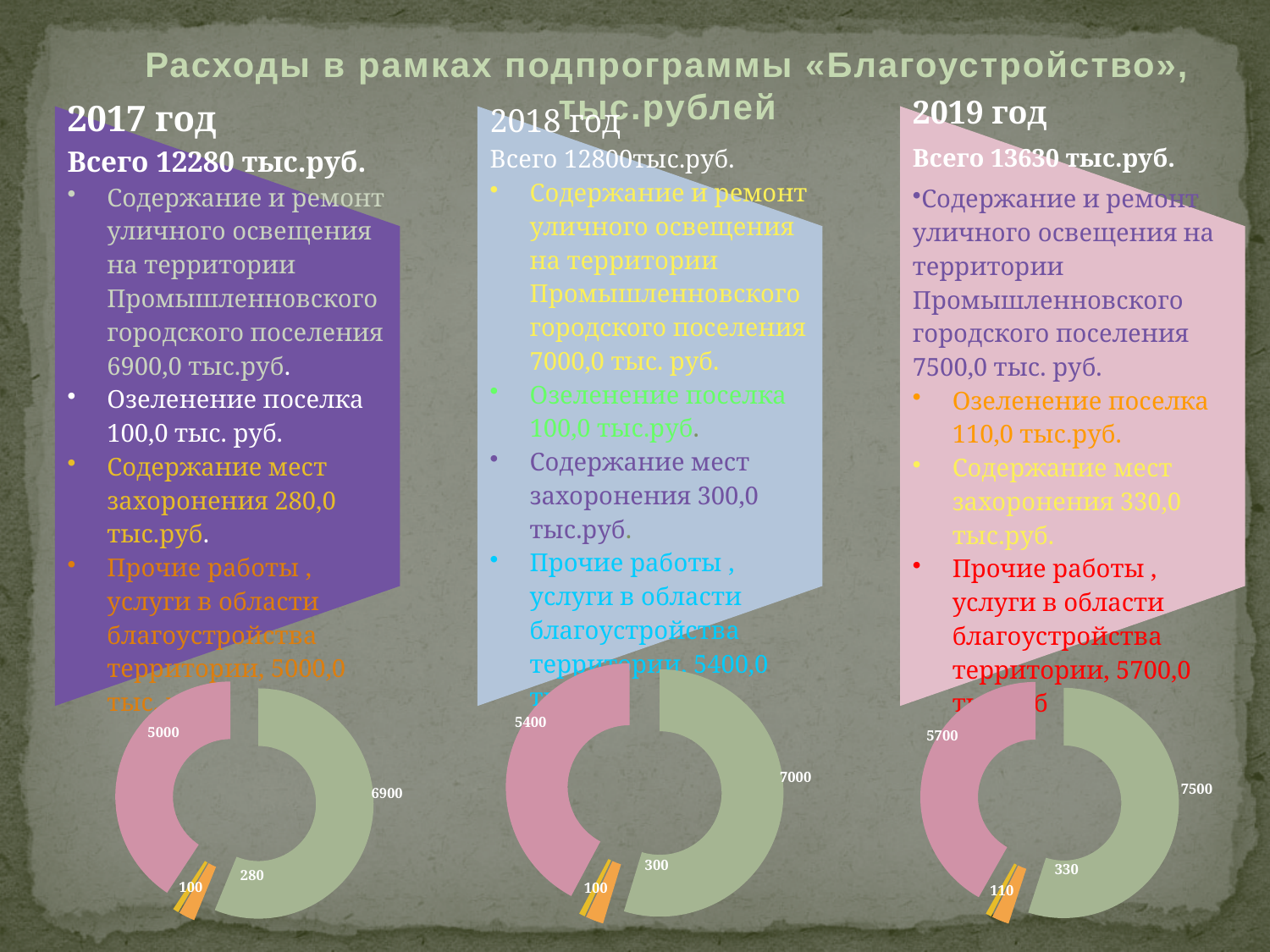
In the left (2017) doughnut chart, what is the value of the smallest slice? 100 In the right (2019) doughnut chart, what is the difference between the 330 slice and the 110 slice? 220 What type of chart is shown at the bottom left of the slide (2017)? doughnut chart In the right (2019) doughnut chart, which is larger: the 5700 slice or the 7500 slice? 7500 In the middle (2018) doughnut chart, what is the total of all four slices? 12800 In the middle (2018) doughnut chart, what is the value of the slice labelled between 7000 and 100? 300 How many slices does the left (2017) doughnut chart have? 4 In the left (2017) doughnut chart, what is the value of the largest slice? 6900 In the middle (2018) doughnut chart, what is the value of the largest slice? 7000 In the right (2019) doughnut chart, what is the value of the smallest slice? 110 In the left (2017) doughnut chart, what is the difference between the 6900 slice and the 5000 slice? 1900 In the right (2019) doughnut chart, what is the value of the largest slice? 7500